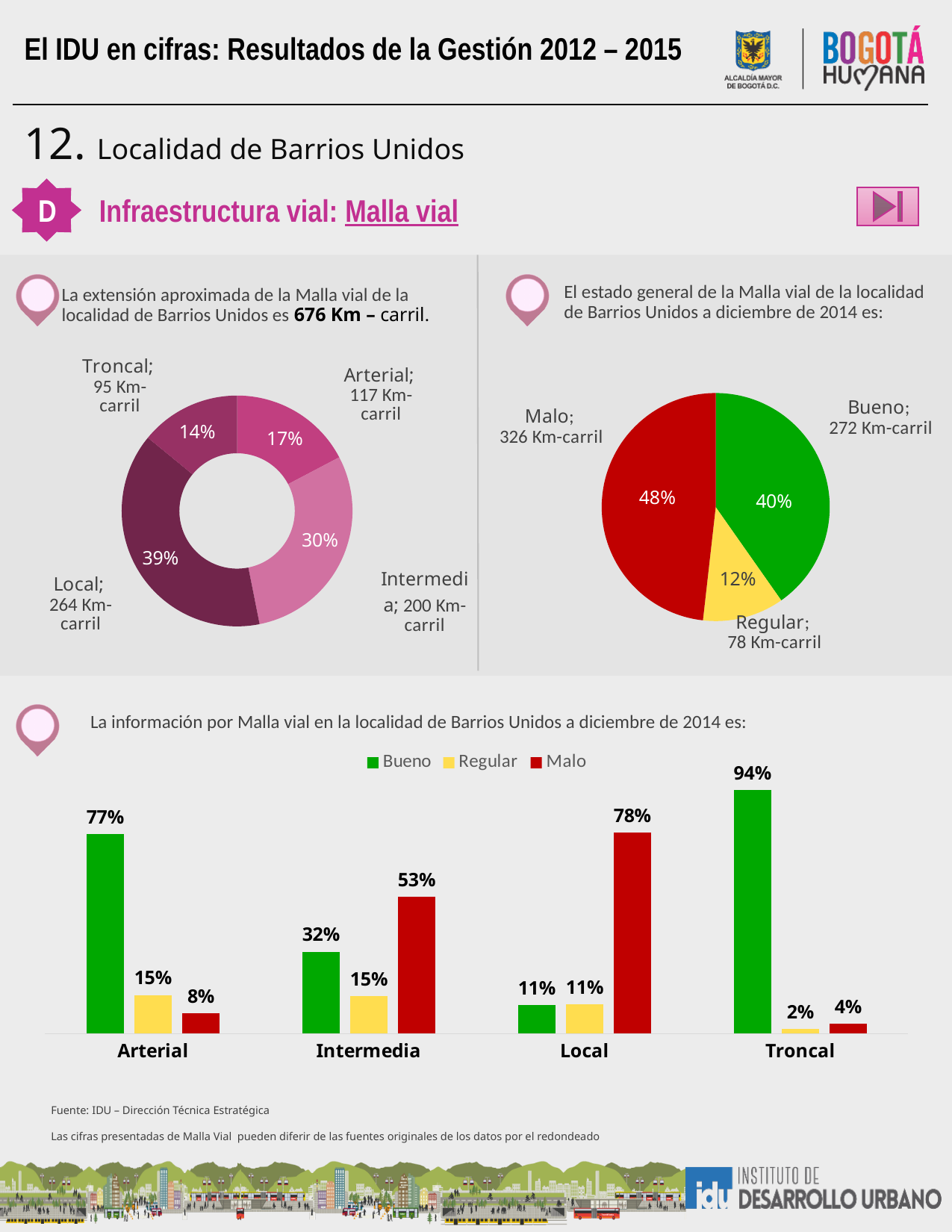
In the bottom bar chart, which is larger for Intermedia: Bueno or Malo? Malo In the donut chart on the left, how many categories are shown? 4 In the bottom bar chart, how many series does the legend list? 3 In the pie chart on the right, what percentage of the road network is in Malo state? 48% In the donut chart on the left, which category has the smallest share? Troncal In the bottom bar chart, what is the Bueno value for Troncal? 94% In the pie chart on the right, how many Km-carril are in Regular state? 78 Km-carril In the donut chart on the left, how many Km-carril does Intermedia have? 200 Km-carril In the pie chart on the right, which state has the largest share? Malo In the donut chart on the left, what share of the road network is Local? 39% What type of chart is the bottom chart? Bar chart In the bottom bar chart, what is the difference between the Malo value for Local and the Bueno value for Local? 67%